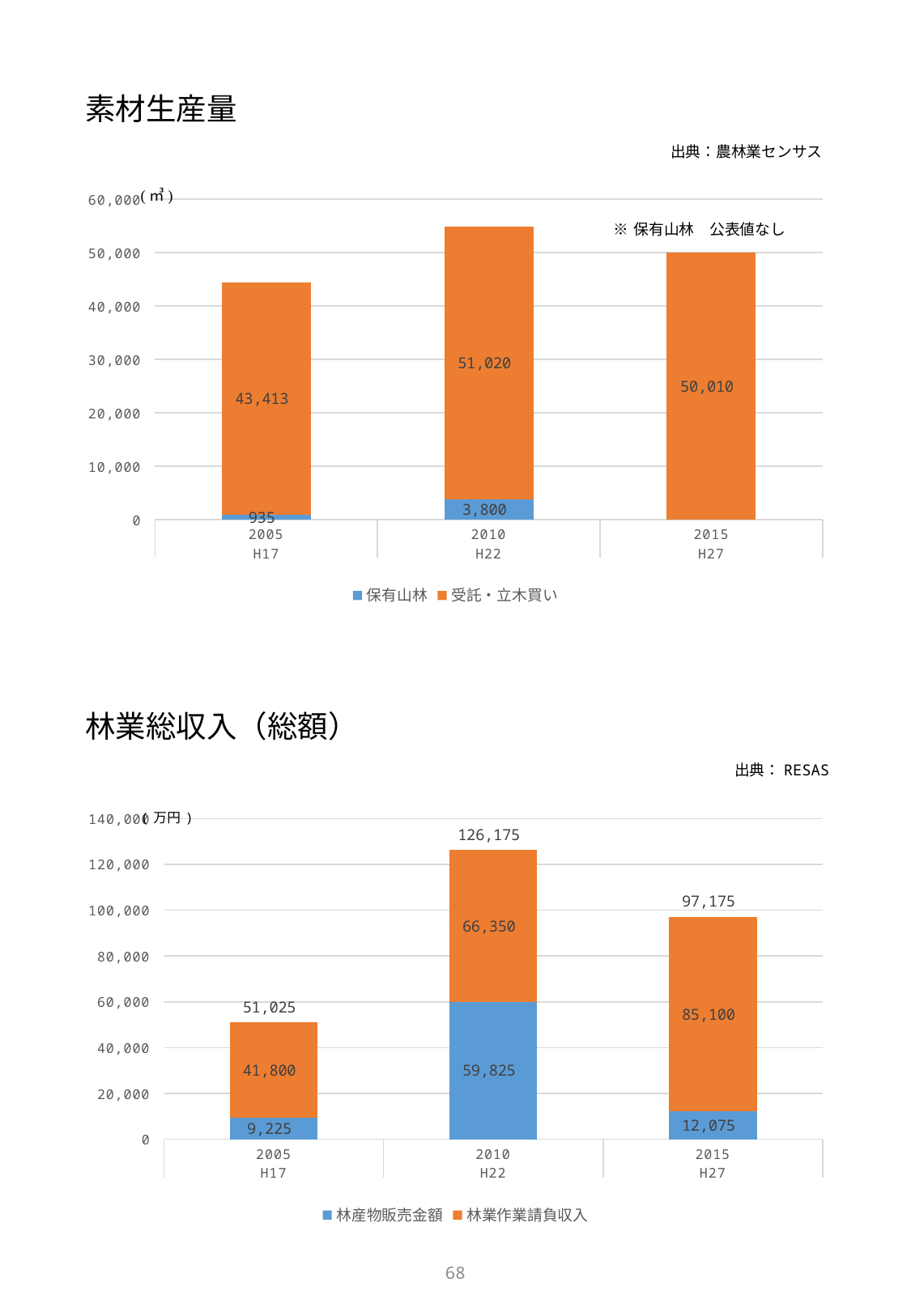
In the 林業総収入（総額） chart, what is the total for 2010 (H22)? 126,175 In the 素材生産量 chart, what is the total of the stacked bar for 2010 (H22)? 54,820 In the 林業総収入（総額） chart, what is the difference between the 林業作業請負収入 values for 2015 (H27) and 2010 (H22)? 18,750 In the 林業総収入（総額） chart, which year has the lowest total? 2005 (H17) In the 素材生産量 chart, which year has the highest 受託・立木買い value? 2010 (H22) In the 素材生産量 chart, what is the value of 保有山林 for 2005 (H17)? 935 What type of chart is the 林業総収入（総額） chart? Stacked bar chart In the 素材生産量 chart, what unit is shown at the top of the vertical axis? ㎥ In the 林業総収入（総額） chart, what is the value of 林産物販売金額 for 2015 (H27)? 12,075 In the 素材生産量 chart, how many series does the legend list? 2 In the 素材生産量 chart, what is the value of 受託・立木買い for 2010 (H22)? 51,020 In the 林業総収入（総額） chart, which is larger for 2010 (H22): 林産物販売金額 or 林業作業請負収入? 林業作業請負収入